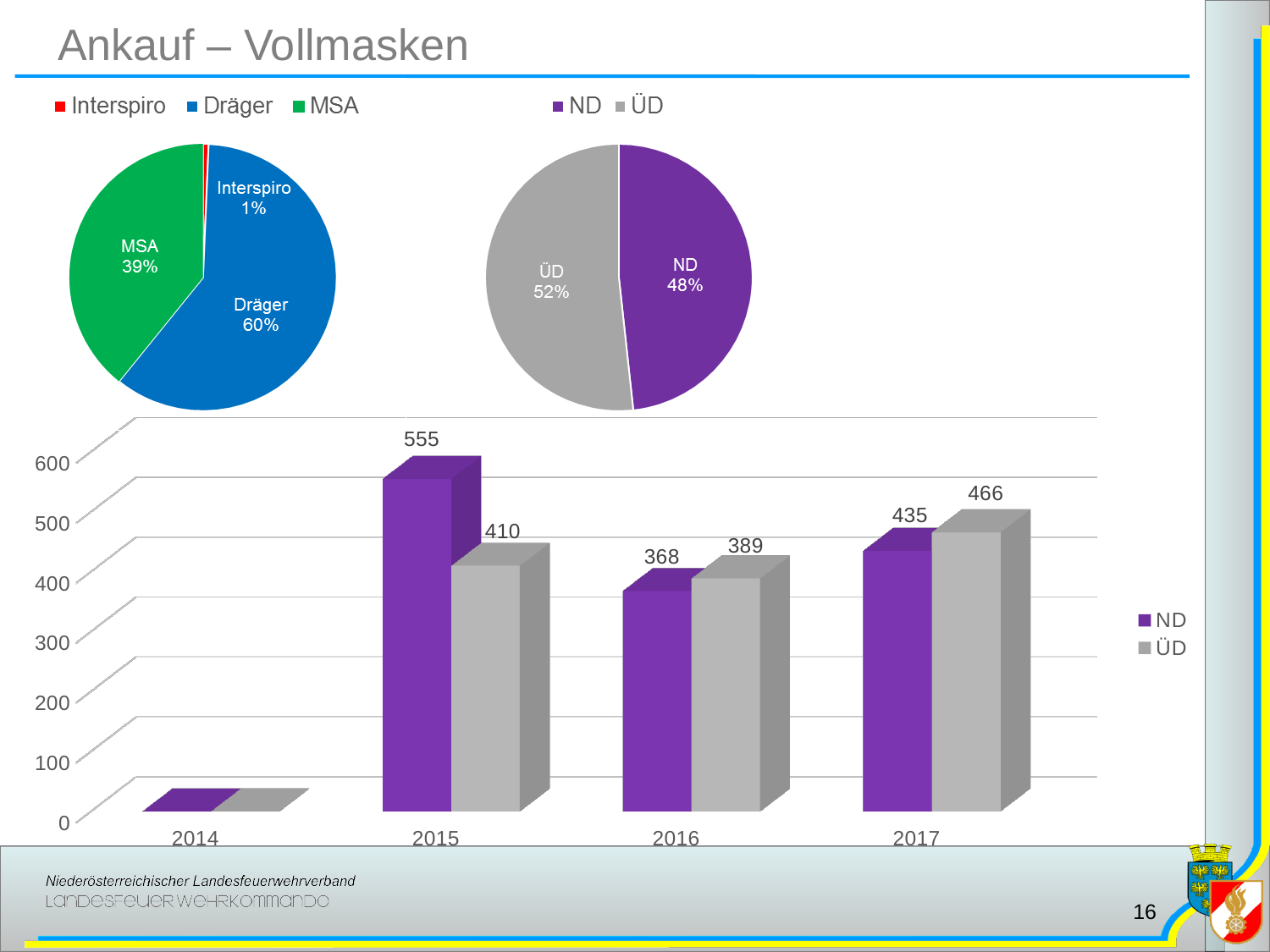
In the left pie chart, what share does Dräger have? 60% In the bottom bar chart, which year has the highest ND value? 2015 In the bottom bar chart, what is the difference between the ND and ÜD values in 2016? 21 In the bottom bar chart, what is the ÜD value for 2017? 466 In the left pie chart, what share does MSA have? 39% In the left pie chart, how many slices are there? 3 What kind of chart is the bottom chart on the slide? Bar chart In the left pie chart, which manufacturer has the smallest share? Interspiro In the bottom bar chart, what is the ND value for 2015? 555 In the right pie chart, what share does ÜD have? 52% In the bottom bar chart, how many series does the legend list? 2 In the right pie chart, which is larger, ND or ÜD? ÜD